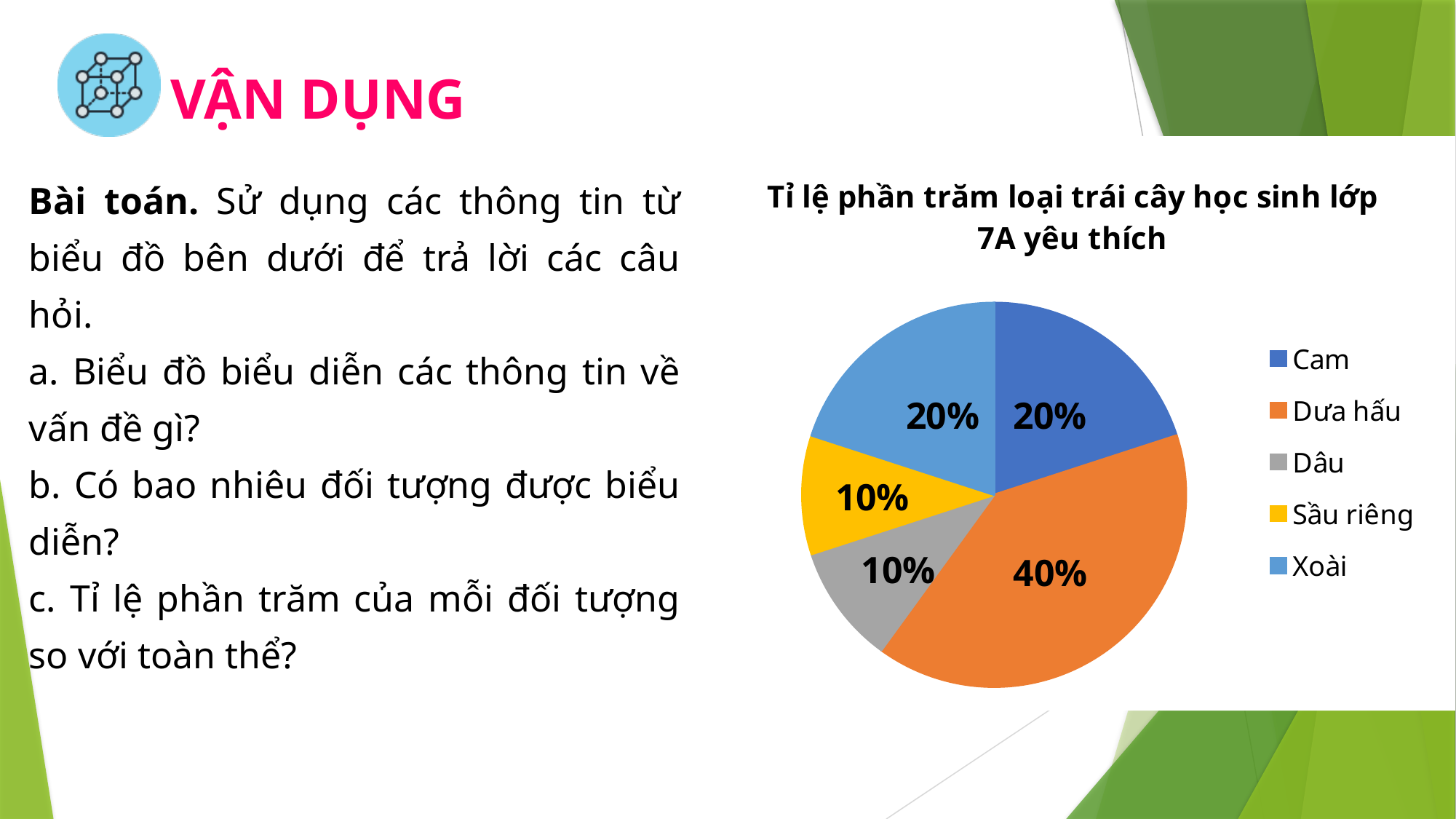
What percentage does the chart show for Xoài? 20% What kind of chart is shown on the slide? Pie chart Which fruit has the largest slice of the pie? Dưa hấu What share of the pie does Dâu represent? 10% What is the difference in percentage points between Dưa hấu and Dâu? 30% What percentage does the chart show for Sầu riêng? 10% What is the title of the chart? Tỉ lệ phần trăm loại trái cây học sinh lớp 7A yêu thích What percentage does the chart show for Cam? 20% What percentage does the chart show for Dưa hấu? 40% How many fruit categories are shown in the pie chart? 5 What is the difference in percentage points between Xoài and Sầu riêng? 10% Which is larger, the slice for Dưa hấu or the slice for Cam? Dưa hấu